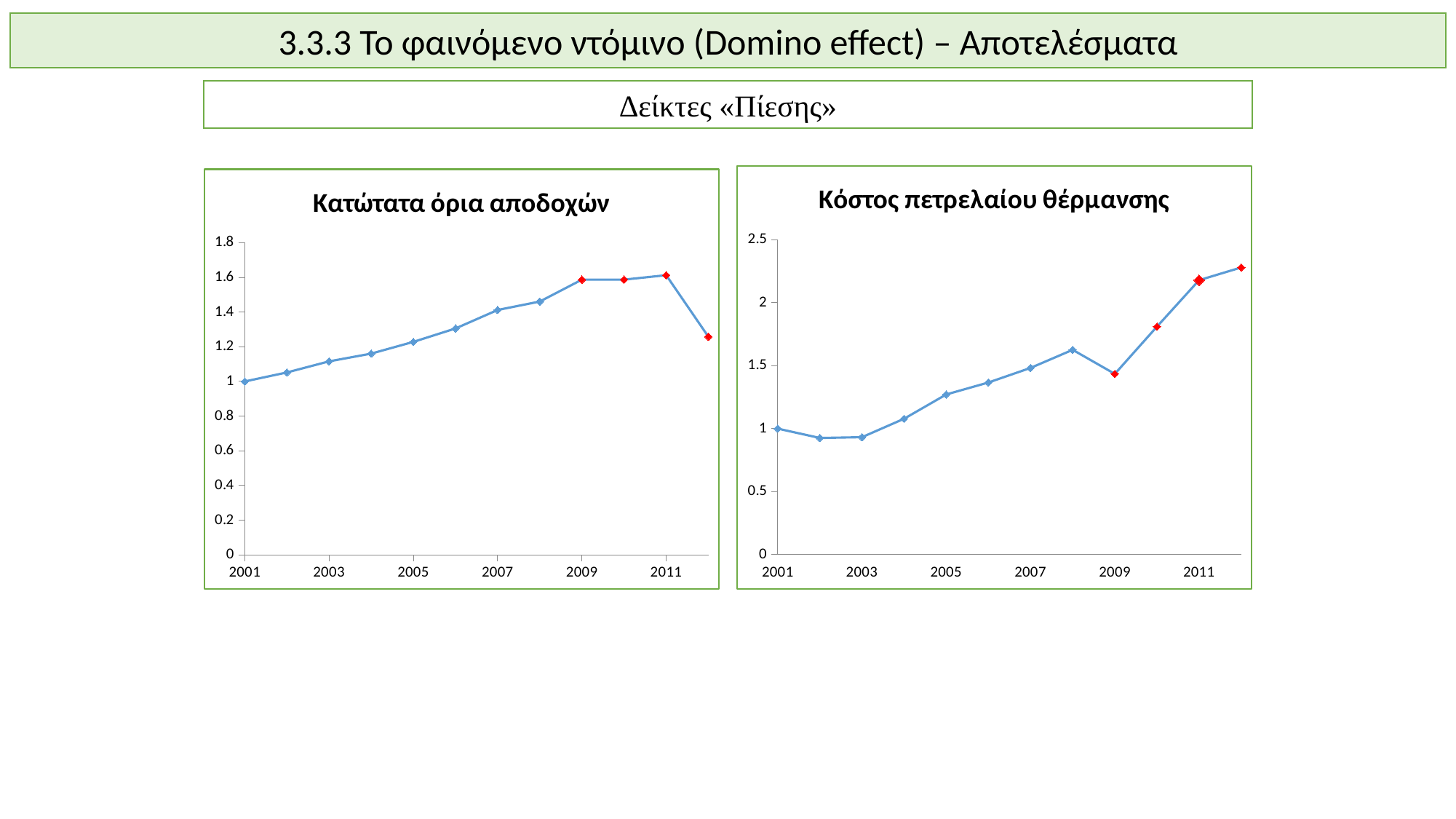
In the 'Κόστος πετρελαίου θέρμανσης' chart, what is the value for 2001? 1 In the 'Κατώτατα όρια αποδοχών' chart, which year has the lowest value? 2001 In the 'Κατώτατα όρια αποδοχών' chart, what is the value for 2001? 1 In the 'Κατώτατα όρια αποδοχών' chart, which year has the highest value? 2011 In the 'Κατώτατα όρια αποδοχών' chart, is the value for 2009 greater or less than 1.4? greater In the 'Κόστος πετρελαίου θέρμανσης' chart, do the values generally rise or fall from 2003 to 2008? rise What kind of chart is the 'Κατώτατα όρια αποδοχών' chart? line chart In the 'Κόστος πετρελαίου θέρμανσης' chart, is the value for 2012 greater or less than 2? greater In the 'Κόστος πετρελαίου θέρμανσης' chart, which year has the highest value? 2012 In the 'Κατώτατα όρια αποδοχών' chart, is the value for 2012 greater or less than 1.4? less How many data points are plotted in the 'Κατώτατα όρια αποδοχών' chart? 12 In the 'Κόστος πετρελαίου θέρμανσης' chart, which is larger, the value for 2008 or the value for 2009? 2008